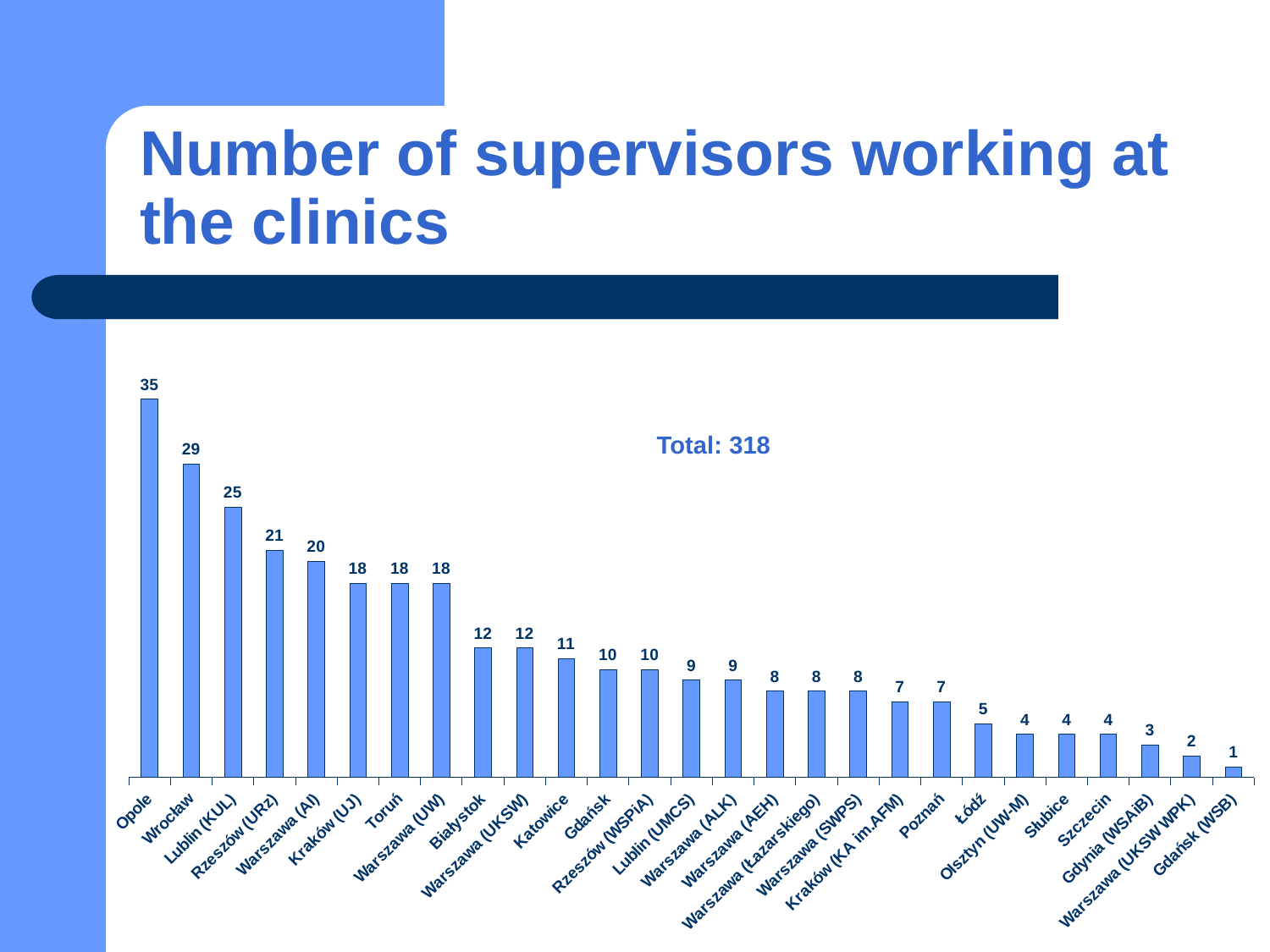
How many supervisors work at the Opole clinic? 35 Which has more supervisors, Białystok or Łódź? Białystok What is the difference in supervisors between Opole and Wrocław? 6 Which clinic has the lowest number of supervisors? Gdańsk (WSB) What is the value shown for Poznań? 7 What total number of supervisors is stated on the chart? 318 How many clinics are shown on the chart? 27 What is the number of supervisors for Katowice? 11 How many supervisors does Gdynia (WSAiB) have? 3 Which clinic has the highest number of supervisors? Opole What type of chart is shown on the slide? Bar chart What is the difference between Lublin (KUL) and Lublin (UMCS)? 16